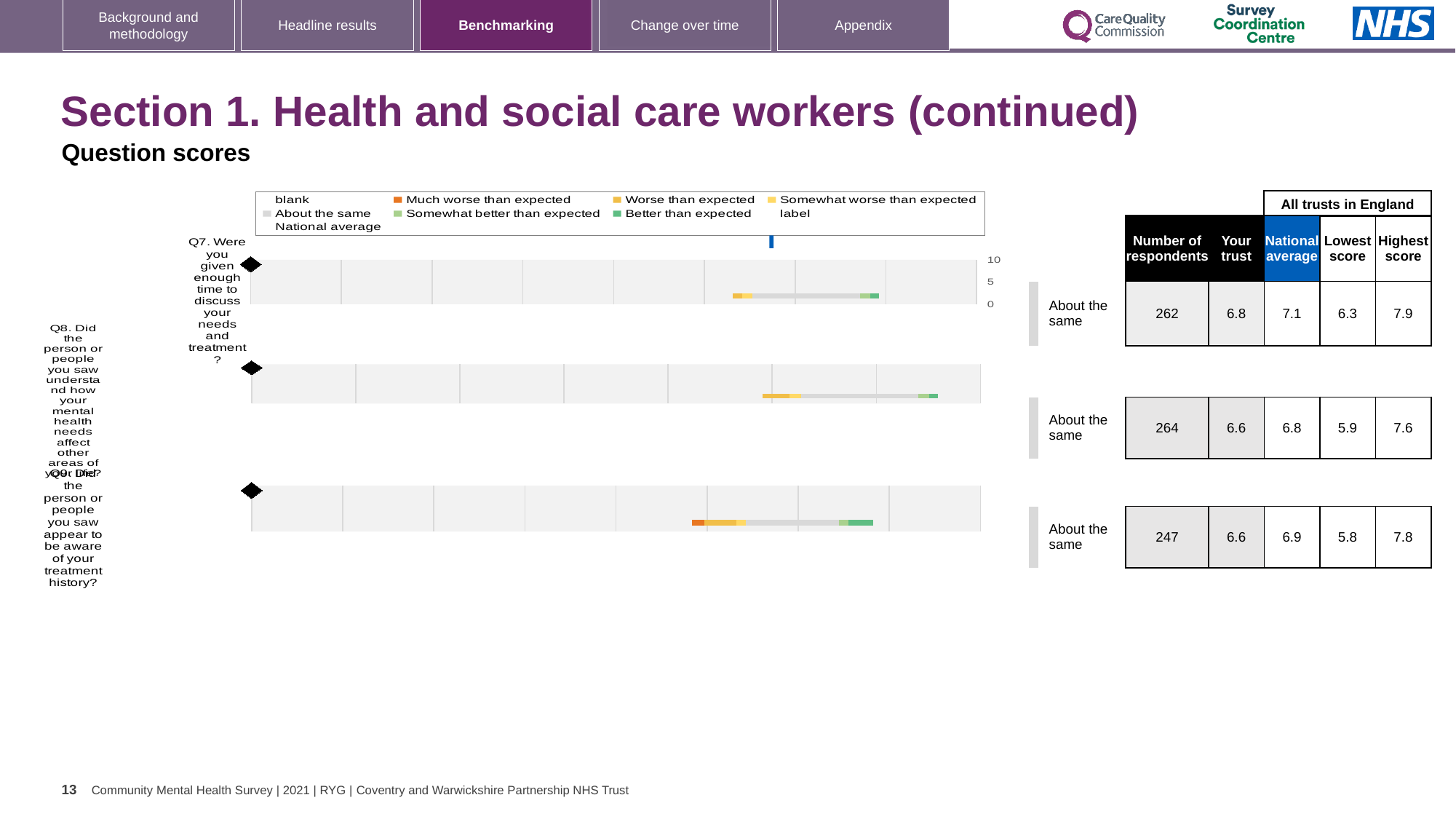
Which question has the highest 'Your trust' score on this slide? Q7 For Q7, what is the difference between the highest score (7.9) and the lowest score (6.3) across all trusts? 1.6 In the chart legend, which colour represents 'Better than expected'? green What kind of chart is used to show the question scores on this slide? bar chart What is the highest score across all trusts in England for Q9? 7.8 Which question has the fewest respondents on this slide? Q9 For Q8 (understanding how mental health needs affect other areas of life), what is the national average score? 6.8 For Q7, which is higher: the 'Your trust' score or the national average? National average For Q7 (time to discuss needs and treatment), what is the 'Your trust' score shown in the table? 6.8 In the chart legend, which colour represents 'Much worse than expected'? orange For Q9 (awareness of treatment history), how many respondents are listed? 247 How many questions (Q7, Q8, Q9) have a benchmarking bar on this slide? 3